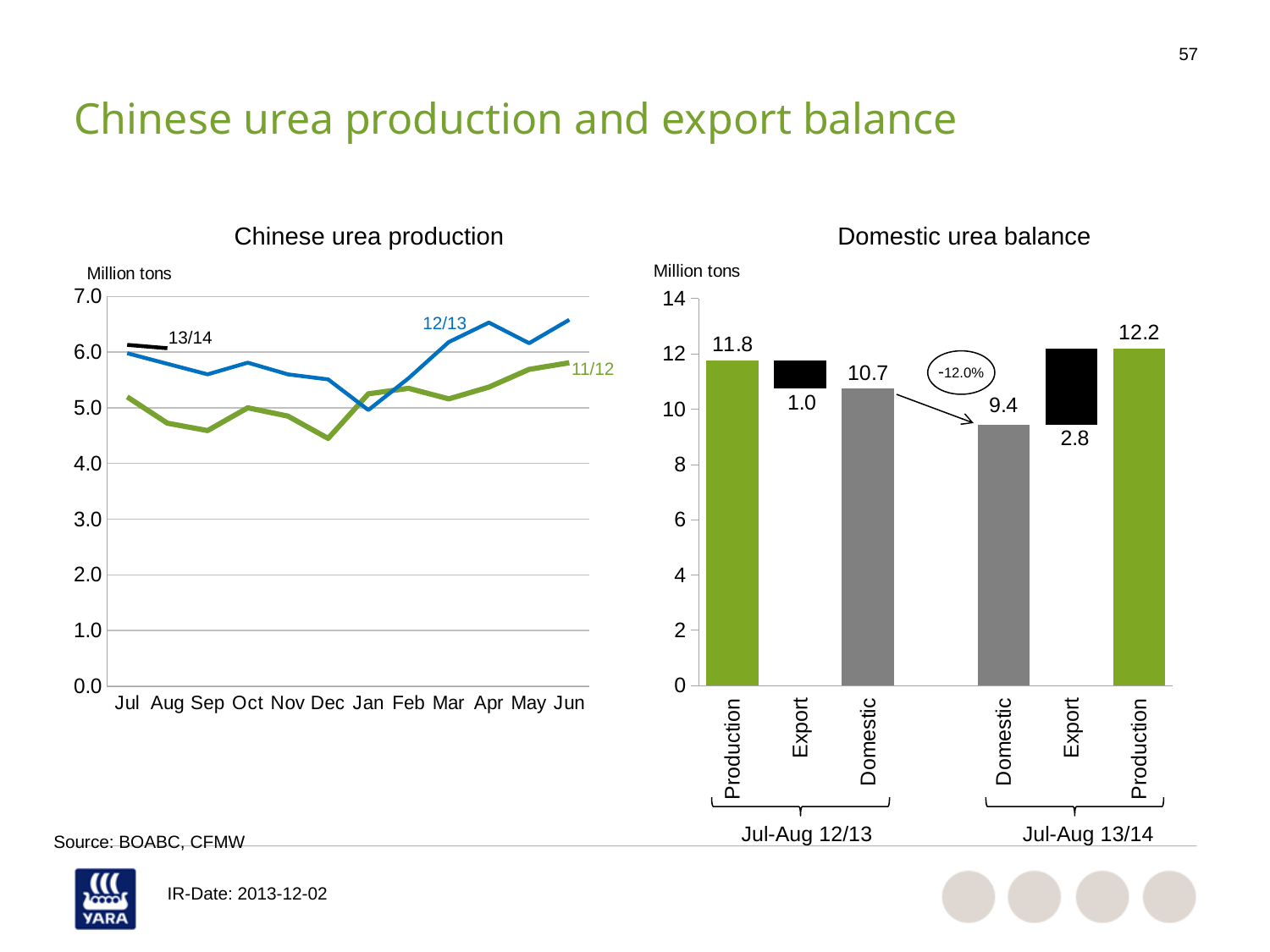
In the Domestic urea balance chart, what is the Domestic value for Jul-Aug 13/14? 9.4 In the Domestic urea balance chart, which period has the larger Domestic value, Jul-Aug 12/13 or Jul-Aug 13/14? Jul-Aug 12/13 In the Domestic urea balance chart, what percentage change is shown in the circle between the two Domestic bars? -12.0% How many series are plotted in the Chinese urea production chart? 3 What kind of chart is the Domestic urea balance chart? bar chart In the Domestic urea balance chart, what is the Export value for Jul-Aug 13/14? 2.8 In the Domestic urea balance chart, which bar has the highest value? Production, Jul-Aug 13/14 In the Chinese urea production chart, is the 12/13 value for Jun greater or less than 6.0? greater In the Domestic urea balance chart, what is the Production value for Jul-Aug 12/13? 11.8 In the Domestic urea balance chart, how much higher is Production in Jul-Aug 13/14 than in Jul-Aug 12/13? 0.4 In the Domestic urea balance chart, what is the difference between the Export values for Jul-Aug 13/14 and Jul-Aug 12/13? 1.8 What kind of chart is the Chinese urea production chart? line chart